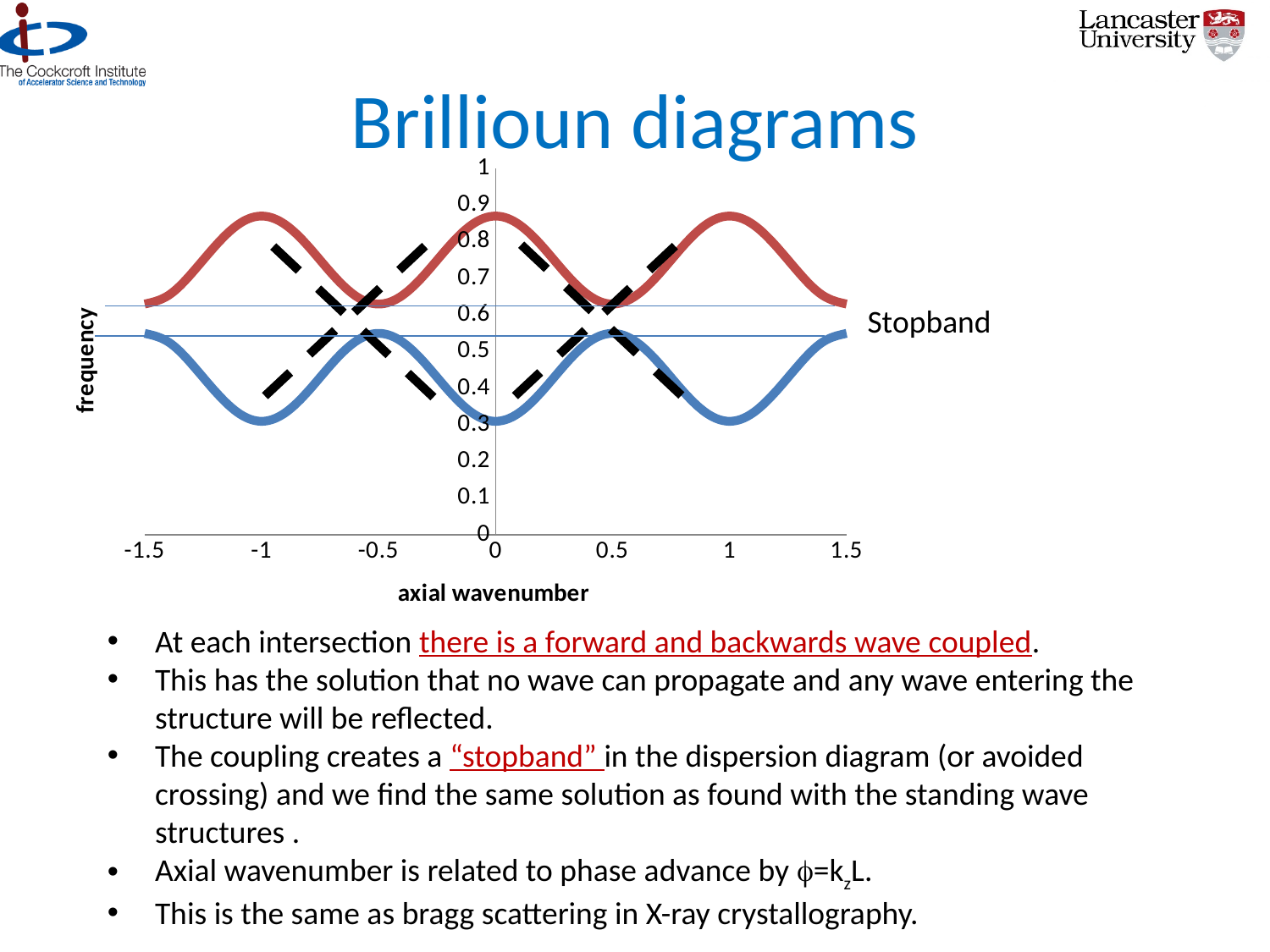
What is the lowest value shown on the x axis of the chart? -1.5 Is the value of the red curve at axial wavenumber -1 greater or less than 0.8? greater Does the red curve rise or fall as the axial wavenumber goes from 0 to 0.5? fall Is the value of the blue curve at axial wavenumber 1 greater or less than 0.4? less At axial wavenumber 0, which curve has the higher frequency, the red curve or the blue curve? red curve What is the title of the y axis of the chart? frequency What is the highest value shown on the y axis of the chart? 1 Is the value of the blue curve at axial wavenumber 0 greater or less than 0.4? less Does the blue curve rise or fall as the axial wavenumber goes from 0 to 0.5? rise What kind of chart is shown on the slide? line chart What is the title of the x axis of the chart? axial wavenumber